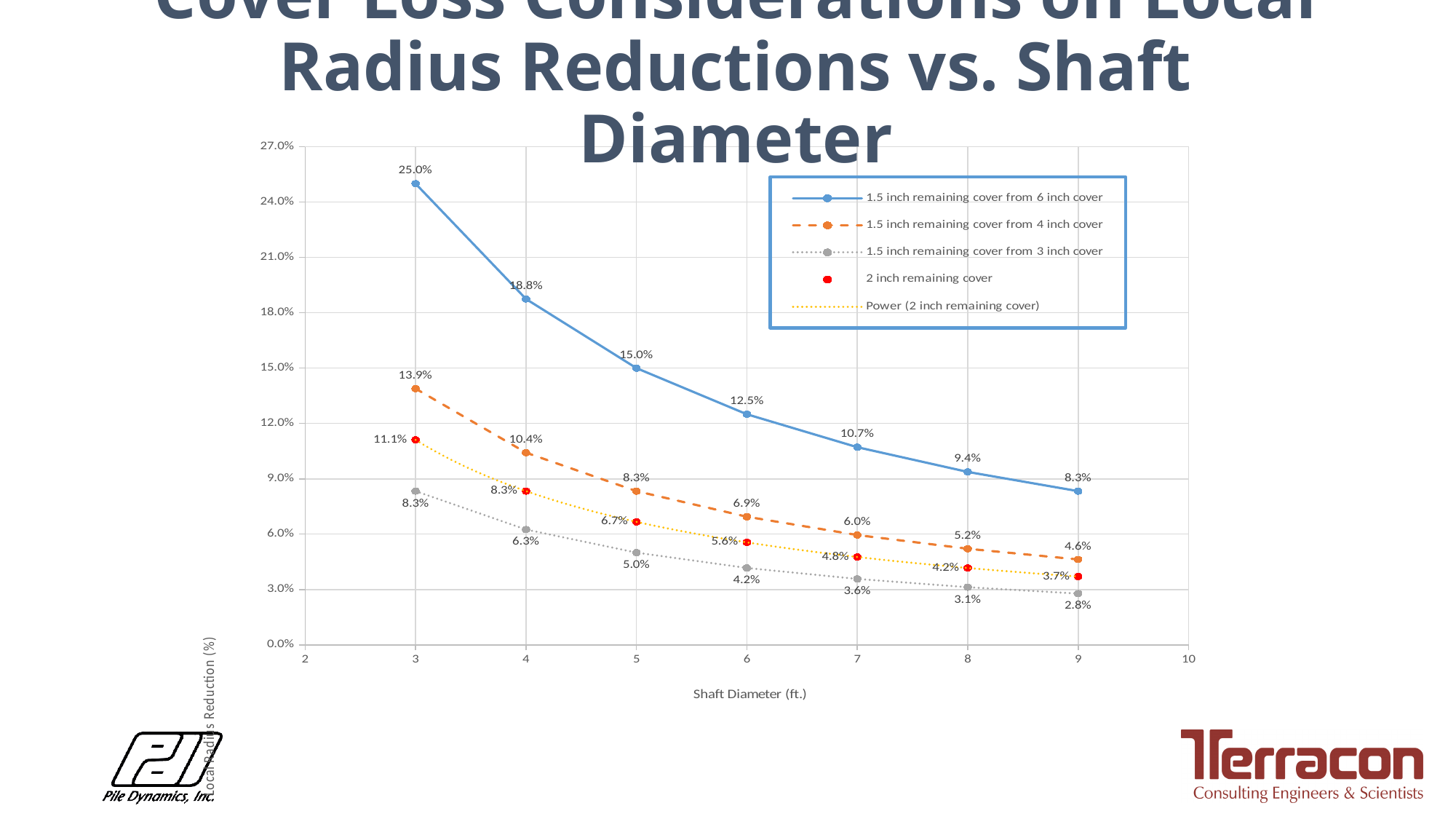
Which series has the lowest value at a shaft diameter of 6 ft? 1.5 inch remaining cover from 3 inch cover Do the values of the '1.5 inch remaining cover from 4 inch cover' series rise or fall as shaft diameter increases? Fall What is the value of the '2 inch remaining cover' series at a shaft diameter of 7 ft? 4.8% What is the difference between the '1.5 inch remaining cover from 6 inch cover' values at shaft diameters of 3 ft and 4 ft? 6.2% What is the value of the '1.5 inch remaining cover from 3 inch cover' series at a shaft diameter of 9 ft? 2.8% At a shaft diameter of 4 ft, which is larger: the '1.5 inch remaining cover from 4 inch cover' value or the '2 inch remaining cover' value? 1.5 inch remaining cover from 4 inch cover What is the local radius reduction for the '1.5 inch remaining cover from 6 inch cover' series at a shaft diameter of 3 ft? 25.0% At which shaft diameter does the '1.5 inch remaining cover from 6 inch cover' series reach its highest value? 3 What kind of chart is shown on the slide? Line chart How many entries does the legend list? 5 How many data points are plotted for the '1.5 inch remaining cover from 6 inch cover' series? 7 What is the value of the '1.5 inch remaining cover from 4 inch cover' series at a shaft diameter of 5 ft? 8.3%